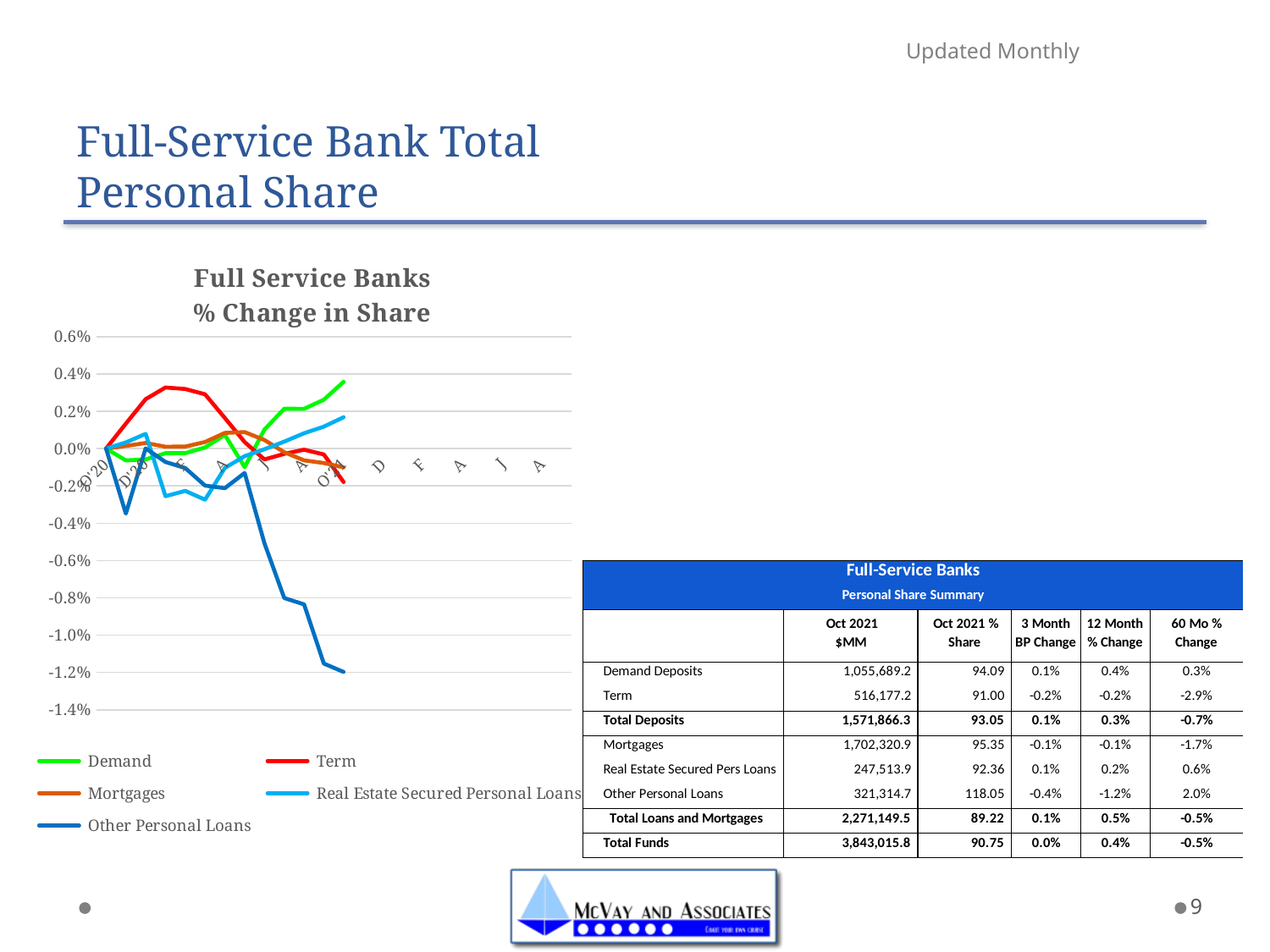
Which series is drawn in green in the chart? Demand What is the lowest value shown on the vertical axis of the chart? -1.4% At the end of the plotted data, which is higher, Demand or Term? Demand Which series has the highest value at the end of the plotted data? Demand Which series has the lowest value at the end of the plotted data? Other Personal Loans Is the final plotted value for Demand greater or less than 0.2%? greater Does the Other Personal Loans line rise or fall over the second half of the plotted period? fall What type of chart is shown on the slide? line chart Is the final plotted value for Other Personal Loans greater or less than -1.0%? less Is the peak value of the Term line greater or less than 0.2%? greater How many series does the legend of the chart list? 5 What is the title of the chart? Full Service Banks % Change in Share